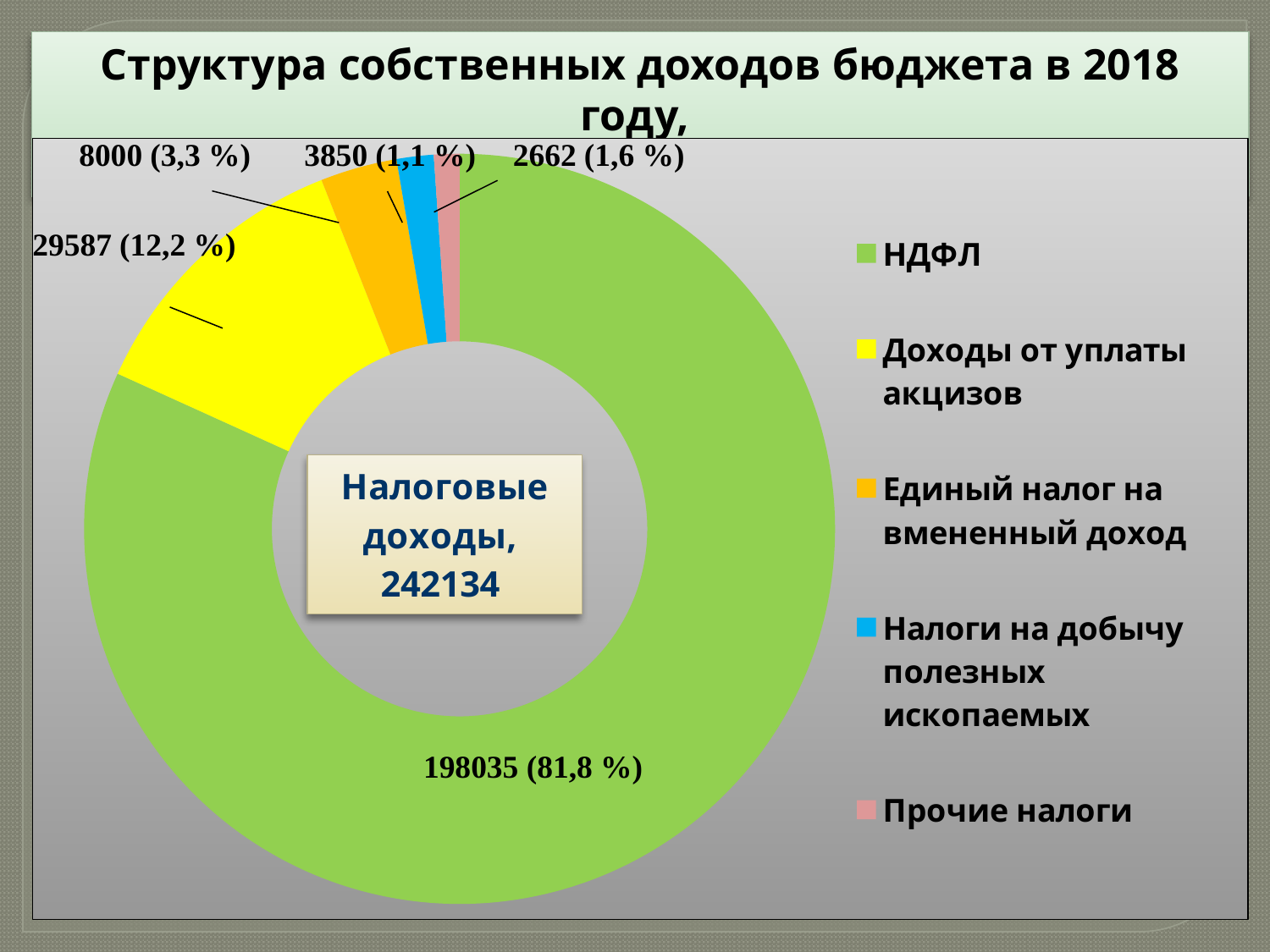
What share of the chart does НДФЛ account for? 81,8 % How many categories does the legend list? 5 What share of the chart does Доходы от уплаты акцизов account for? 12,2 % What is the value shown for Прочие налоги? 2662 Which category has the largest slice? НДФЛ What is the value shown for Доходы от уплаты акцизов? 29587 What is the value shown for Единый налог на вмененный доход? 8000 What total is shown in the centre of the chart for Налоговые доходы? 242134 What kind of chart is shown on the slide? Doughnut (pie) chart What is the value shown for НДФЛ? 198035 What is the difference between the values for НДФЛ and Доходы от уплаты акцизов? 168448 What is the value shown for Налоги на добычу полезных ископаемых? 3850